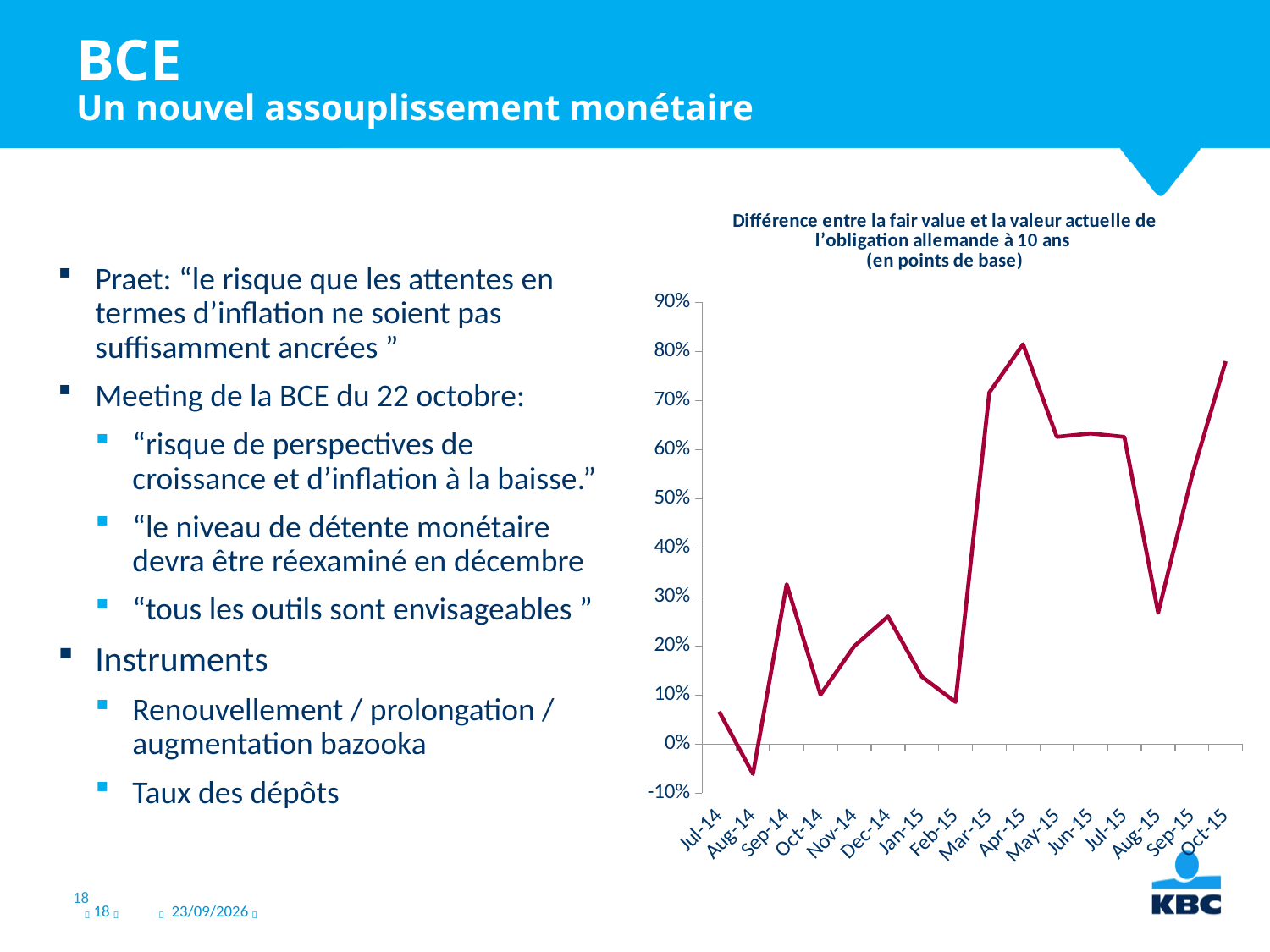
What is the unit stated in parentheses in the chart title? en points de base Is the value for Sep-14 greater or less than 30%? greater Which month has the lowest value in the chart? Aug-14 Which is larger, the value for Dec-14 or the value for Jan-15? Dec-14 What kind of chart is shown on the slide? line chart Is the value for Feb-15 greater or less than 10%? less How many months are plotted along the x axis of the chart? 16 Does the line rise or fall between Jul-15 and Aug-15? fall Is the value for Aug-14 greater or less than 0%? less Which is larger, the value for Aug-15 or the value for Sep-15? Sep-15 Which month has the highest value in the chart? Apr-15